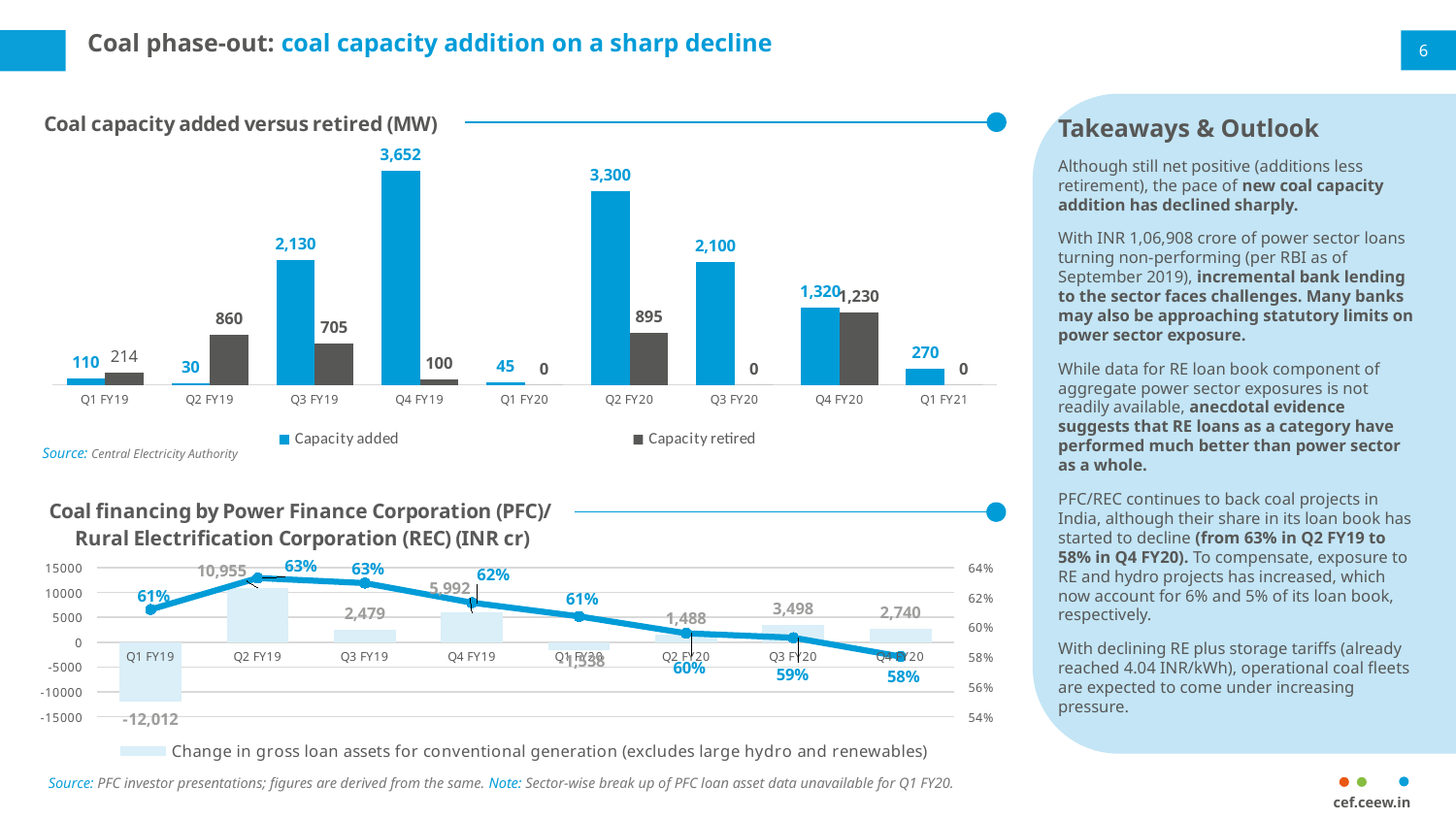
How many series does the legend of the 'Coal capacity added versus retired (MW)' chart list? 2 In the 'Coal capacity added versus retired (MW)' chart, which is larger in Q2 FY19: capacity added or capacity retired? Capacity retired In the 'Coal capacity added versus retired (MW)' chart, what is the capacity retired in Q2 FY19? 860 In the 'Coal capacity added versus retired (MW)' chart, what is the capacity added in Q4 FY19? 3,652 In the 'Coal financing by Power Finance Corporation (PFC)/Rural Electrification Corporation (REC) (INR cr)' chart, what is the change in gross loan assets for conventional generation in Q1 FY19? -12,012 How many quarters are shown on the x axis of the 'Coal capacity added versus retired (MW)' chart? 9 In the 'Coal financing by Power Finance Corporation (PFC)/Rural Electrification Corporation (REC) (INR cr)' chart, does the percentage line rise or fall from Q3 FY19 to Q4 FY20? Fall In the 'Coal financing by Power Finance Corporation (PFC)/Rural Electrification Corporation (REC) (INR cr)' chart, what is the percentage shown for Q4 FY20 on the line? 58% In the 'Coal capacity added versus retired (MW)' chart, what is the difference between capacity added and capacity retired in Q4 FY20? 90 What kind of chart is the 'Coal capacity added versus retired (MW)' chart? Bar chart In the 'Coal capacity added versus retired (MW)' chart, which quarter has the lowest capacity added? Q2 FY19 In the 'Coal capacity added versus retired (MW)' chart, which quarter has the highest capacity added? Q4 FY19